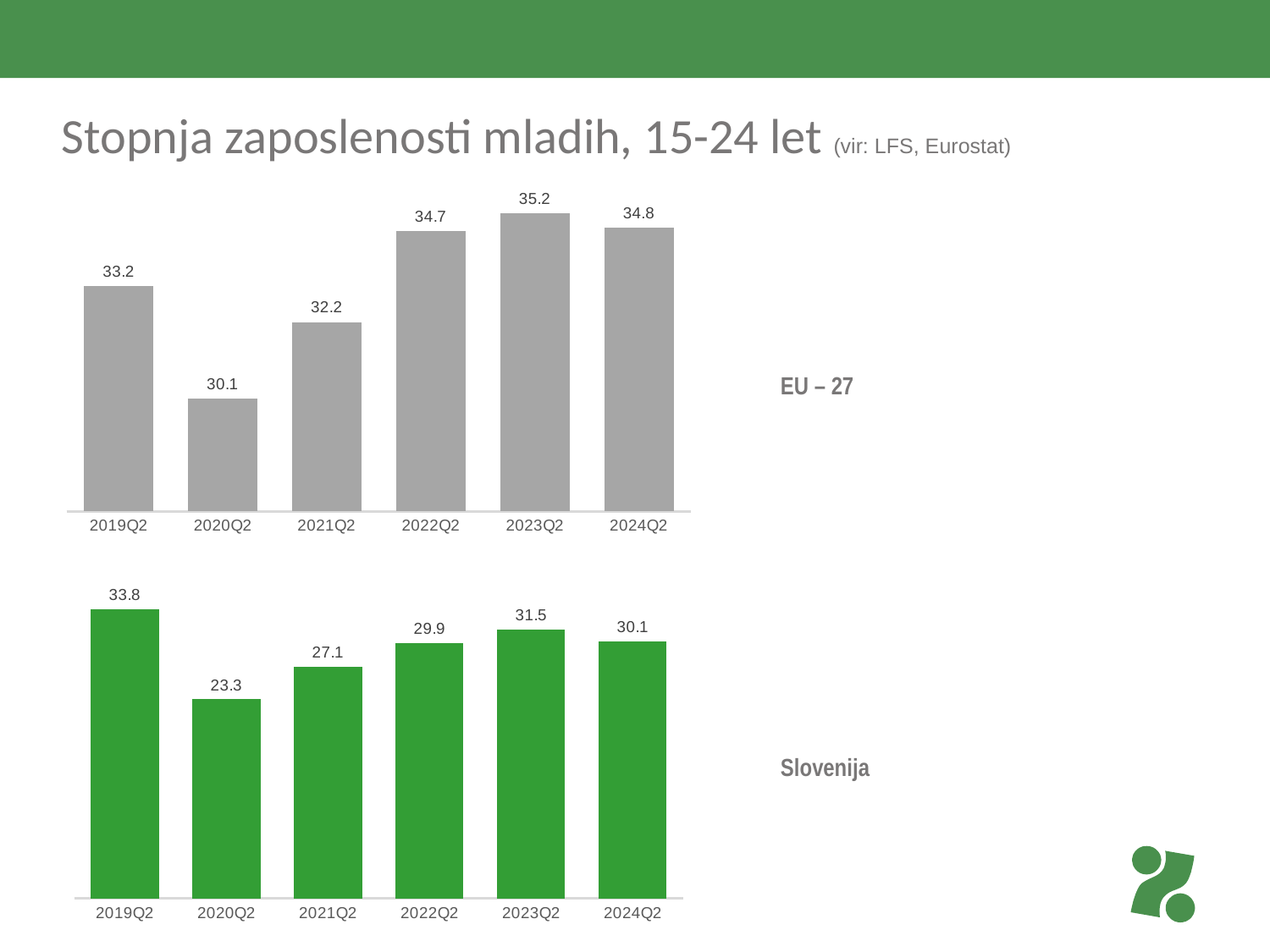
In the EU – 27 chart (top), what is the value for 2023Q2? 35.2 In the EU – 27 chart (top), which period has the lowest value? 2020Q2 In the Slovenija chart (bottom), what is the value for 2020Q2? 23.3 In the Slovenija chart (bottom), do the values rise or fall from 2020Q2 to 2023Q2? Rise In the Slovenija chart (bottom), which is larger, the value for 2023Q2 or the value for 2024Q2? 2023Q2 In the EU – 27 chart (top), what is the difference between the values for 2024Q2 and 2019Q2? 1.6 In the Slovenija chart (bottom), what is the difference between the values for 2019Q2 and 2020Q2? 10.5 What kind of chart is the EU – 27 chart (top)? Bar chart How many periods are shown on the x axis of the Slovenija chart (bottom)? 6 What colour are the bars in the Slovenija chart (bottom)? Green In the EU – 27 chart (top), which is larger, the value for 2021Q2 or the value for 2022Q2? 2022Q2 In the Slovenija chart (bottom), which period has the highest value? 2019Q2